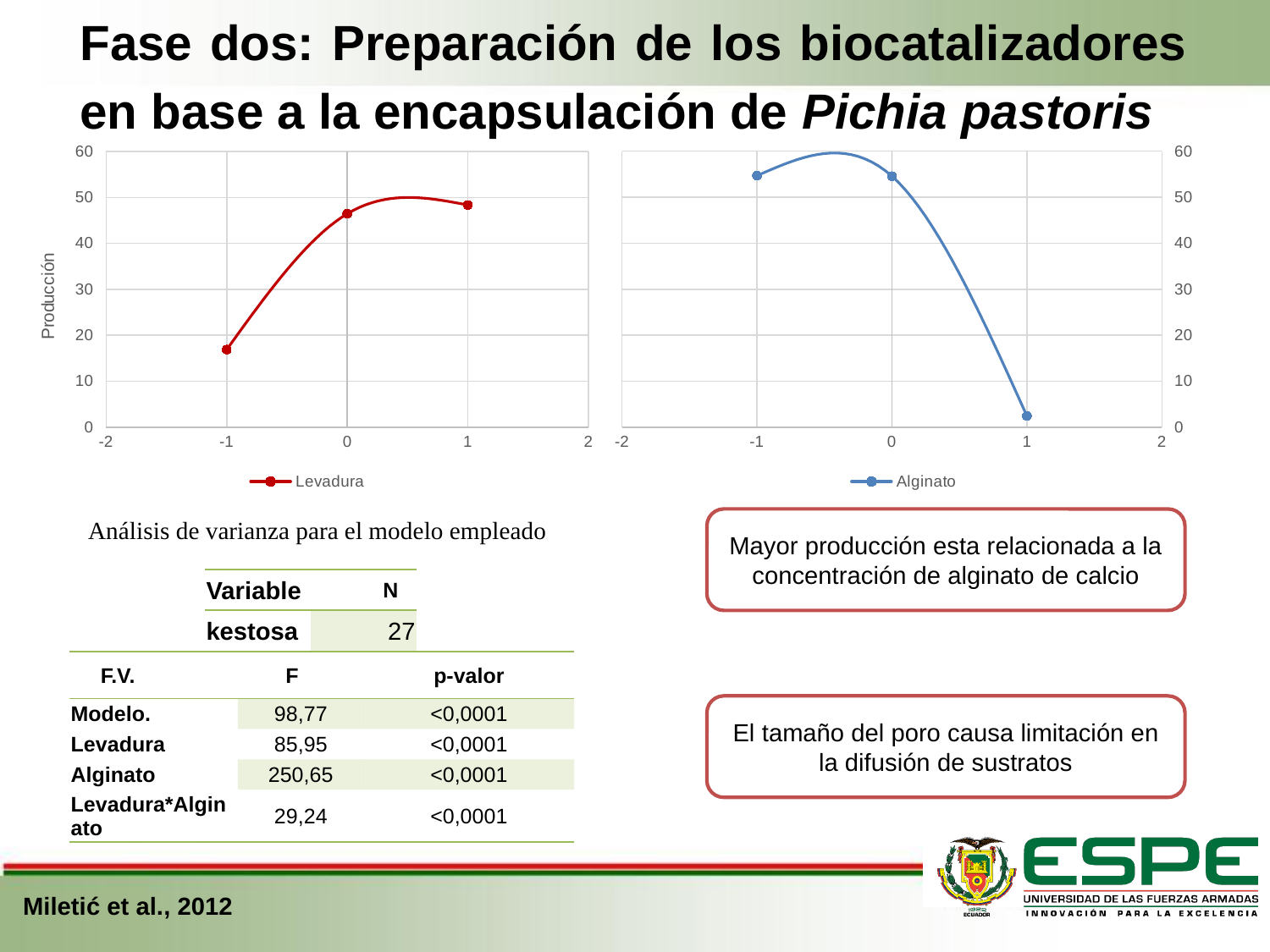
On the left chart (Levadura), is the value at x = -1 greater or less than 20? less On the left chart (Levadura), do the values rise or fall from x = -1 to x = 0? rise On the right chart (Alginato), at which x value is the plotted value lowest? 1 On the right chart (Alginato), is the value at x = -1 greater or less than 50? greater On the left chart (Levadura), at which x value is the plotted value lowest? -1 On the right chart (Alginato), is the value at x = 1 greater or less than 10? less What kind of chart is the left chart (Levadura)? line chart How many data points are plotted on the left chart (Levadura)? 3 How many series does the legend of the right chart (Alginato) list? 1 On the right chart (Alginato), do the values rise or fall from x = 0 to x = 1? fall What is the y-axis title of the left chart? Producción